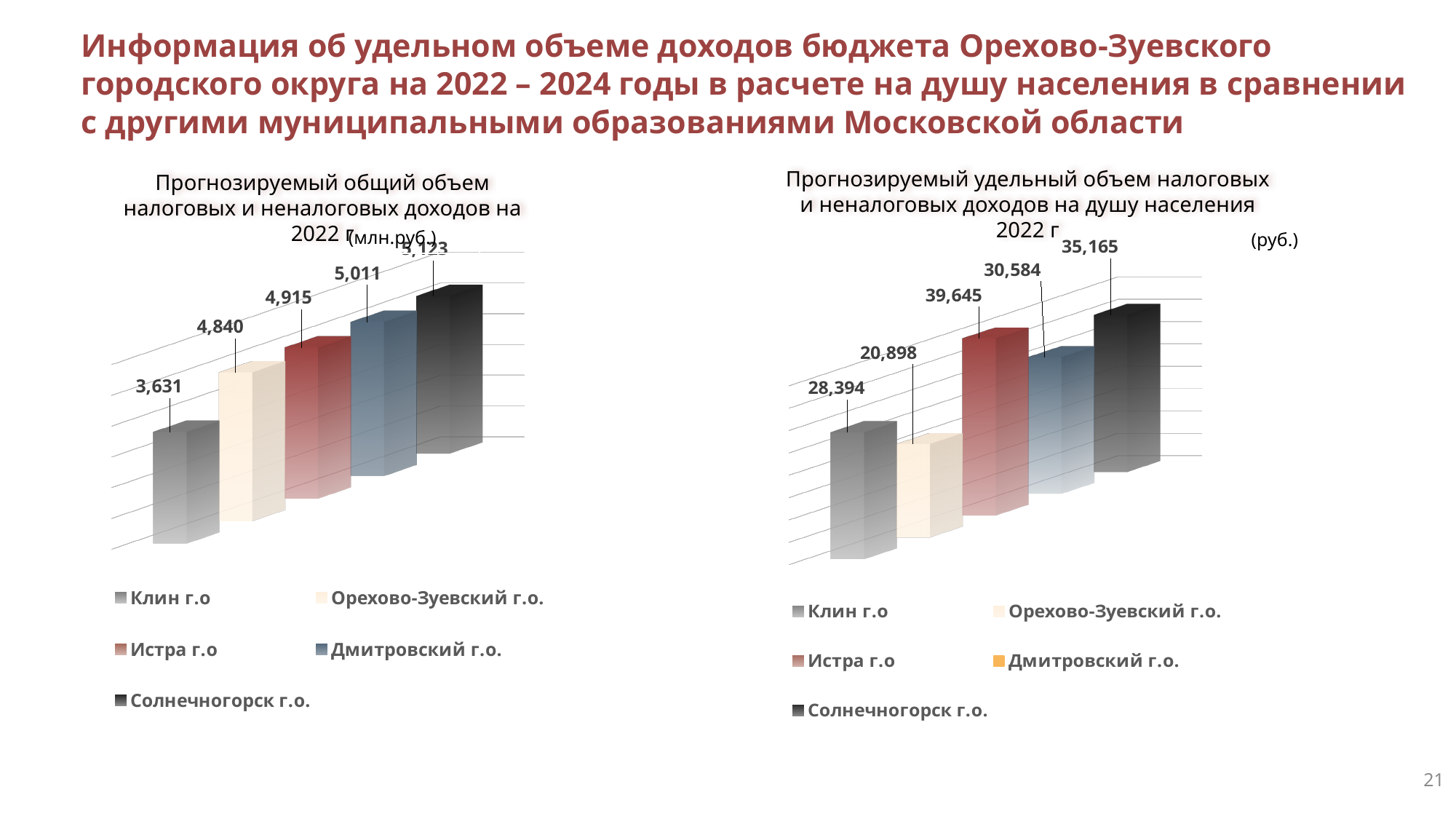
In the right chart (Прогнозируемый удельный объем налоговых и неналоговых доходов на душу населения 2022 г), what is the difference between the values for Солнечногорск г.о. and Дмитровский г.о.? 4,581 In the left chart (Прогнозируемый общий объем налоговых и неналоговых доходов на 2022 г), what is the value for Клин г.о? 3,631 In the right chart (Прогнозируемый удельный объем налоговых и неналоговых доходов на душу населения 2022 г), what is the value for Орехово-Зуевский г.о.? 20,898 In the left chart (Прогнозируемый общий объем налоговых и неналоговых доходов на 2022 г), which municipality has the highest value? Солнечногорск г.о. In the right chart (Прогнозируемый удельный объем налоговых и неналоговых доходов на душу населения 2022 г), which municipality has the lowest value? Орехово-Зуевский г.о. In the right chart (Прогнозируемый удельный объем налоговых и неналоговых доходов на душу населения 2022 г), what is the value for Истра г.о? 39,645 In the left chart (Прогнозируемый общий объем налоговых и неналоговых доходов на 2022 г), what is the difference between the values for Истра г.о and Орехово-Зуевский г.о.? 75 In the left chart (Прогнозируемый общий объем налоговых и неналоговых доходов на 2022 г), what is the value for Орехово-Зуевский г.о.? 4,840 How many municipalities are listed in the legend of the left chart? 5 In the right chart (Прогнозируемый удельный объем налоговых и неналоговых доходов на душу населения 2022 г), which is larger: the value for Клин г.о or for Дмитровский г.о.? Дмитровский г.о. In the right chart (Прогнозируемый удельный объем налоговых и неналоговых доходов на душу населения 2022 г), which municipality has the highest value? Истра г.о In the left chart (Прогнозируемый общий объем налоговых и неналоговых доходов на 2022 г), which municipality has the lowest value? Клин г.о